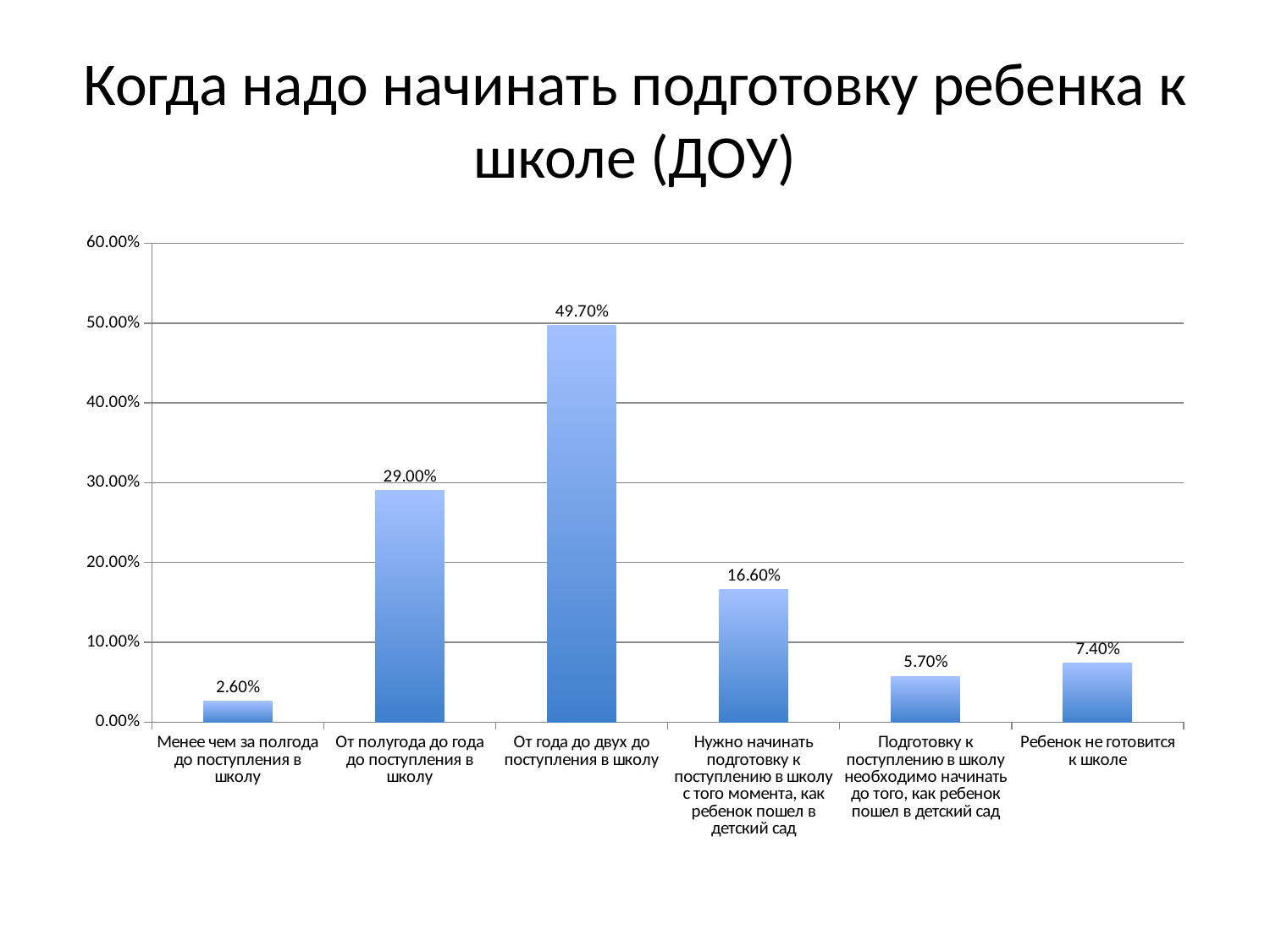
What is the title of the slide? Когда надо начинать подготовку ребенка к школе (ДОУ) Which category has the highest value? От года до двух до поступления в школу What kind of chart is shown on the slide? bar chart Is the value for "Нужно начинать подготовку к поступлению в школу с того момента, как ребенок пошел в детский сад" greater or less than 20.00%? less What is the value for "Менее чем за полгода до поступления в школу"? 2.60% How many categories are shown on the x axis? 6 What is the difference between the values for "От года до двух до поступления в школу" and "От полугода до года до поступления в школу"? 20.70% Which category has the lowest value? Менее чем за полгода до поступления в школу What is the value for "От года до двух до поступления в школу"? 49.70% What is the value for "Ребенок не готовится к школе"? 7.40% What is the value for "От полугода до года до поступления в школу"? 29.00% Which is larger: the value for "Ребенок не готовится к школе" or the value for "Подготовку к поступлению в школу необходимо начинать до того, как ребенок пошел в детский сад"? Ребенок не готовится к школе